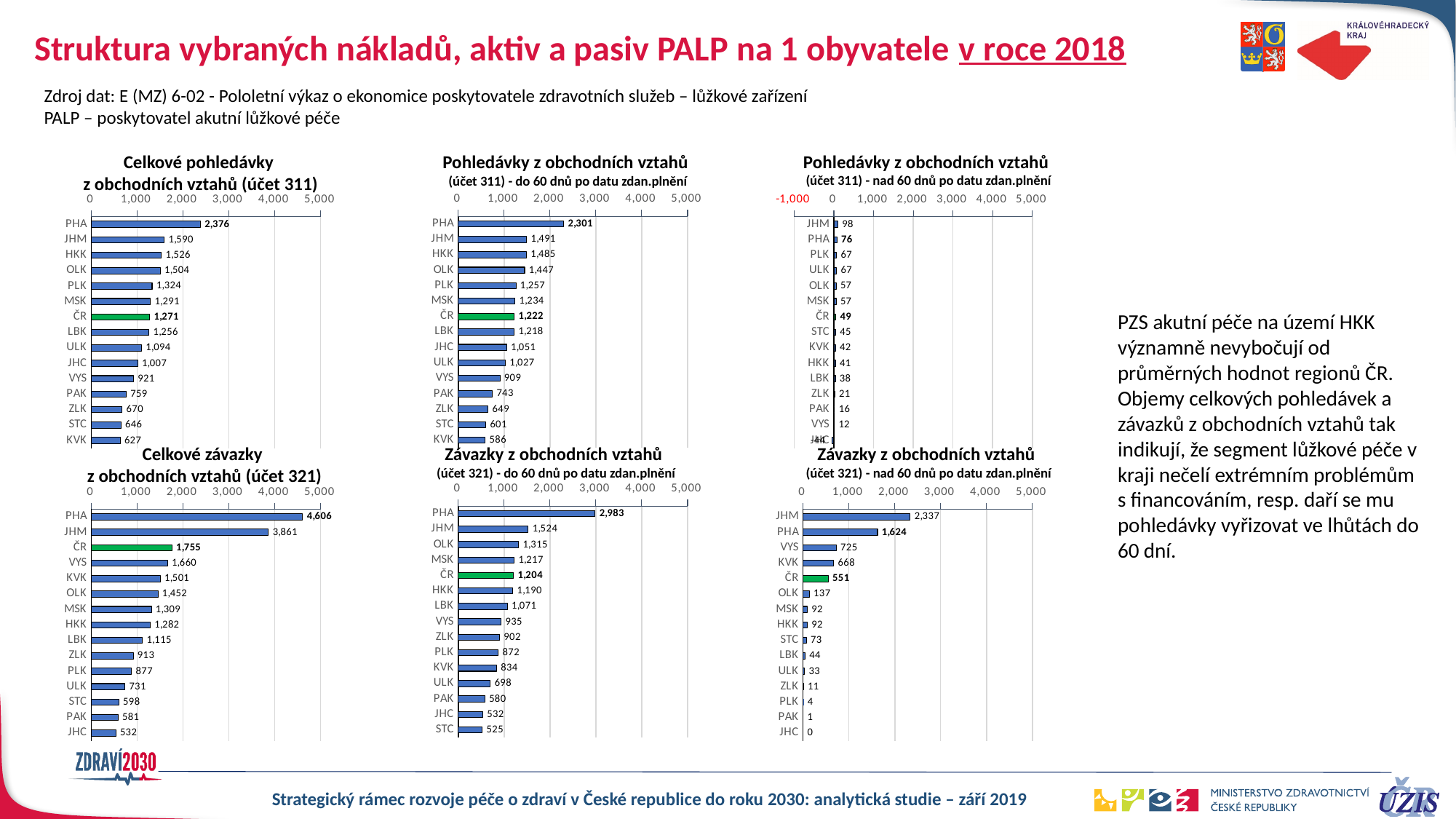
In the chart 'Celkové závazky z obchodních vztahů (účet 321)', what is the value for PHA? 4,606 In the chart 'Celkové závazky z obchodních vztahů (účet 321)', which is larger, the value for HKK or the value for VYS? VYS In the chart 'Celkové pohledávky z obchodních vztahů (účet 311)', which region has the highest value? PHA What type of chart is 'Závazky z obchodních vztahů (účet 321) - nad 60 dnů po datu zdan.plnění'? Bar chart In the chart 'Celkové pohledávky z obchodních vztahů (účet 311)', what is the value for HKK? 1,526 In the chart 'Pohledávky z obchodních vztahů (účet 311) - nad 60 dnů po datu zdan.plnění', what is the value for JHM? 98 In the chart 'Celkové závazky z obchodních vztahů (účet 321)', how many categories are shown? 15 In the chart 'Pohledávky z obchodních vztahů (účet 311) - do 60 dnů po datu zdan.plnění', what is the value for ČR? 1,222 In the chart 'Závazky z obchodních vztahů (účet 321) - nad 60 dnů po datu zdan.plnění', what is the difference between JHM and PHA? 713 In the chart 'Pohledávky z obchodních vztahů (účet 311) - do 60 dnů po datu zdan.plnění', which region has the lowest value? KVK In the chart 'Závazky z obchodních vztahů (účet 321) - do 60 dnů po datu zdan.plnění', what is the value for HKK? 1,190 In the chart 'Celkové pohledávky z obchodních vztahů (účet 311)', what is the difference between PHA and ČR? 1,105